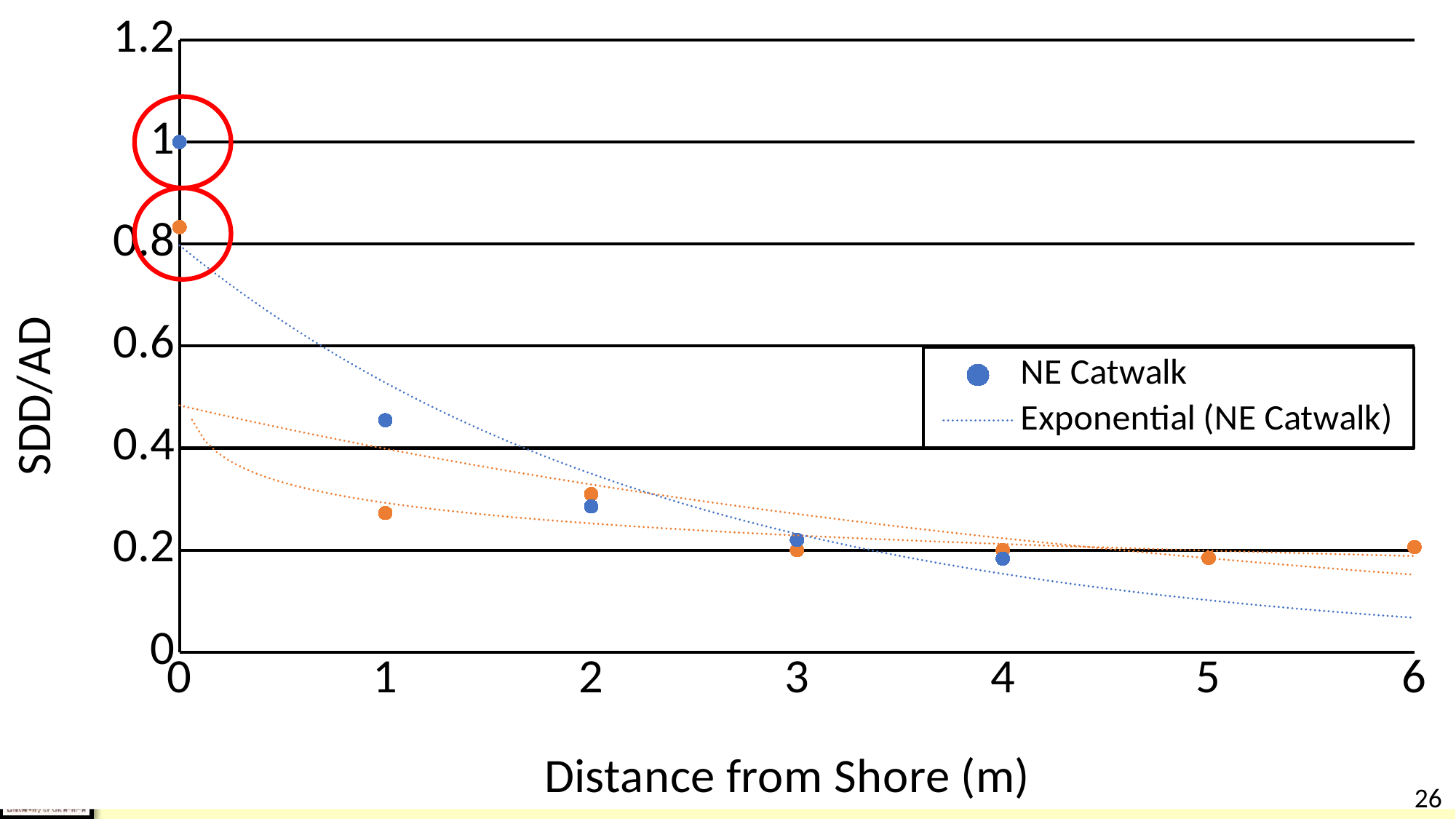
What is the label of the y axis? SDD/AD What is the SDD/AD value for NE Catwalk at a distance of 0 m from shore? 1 How many entries does the legend list? 2 What kind of chart is shown on the slide? Scatter chart Is the NE Catwalk value at 2 m from shore greater or less than 0.4? less Do the SDD/AD values rise or fall as distance from shore increases? Fall How many blue NE Catwalk data points are plotted? 5 Is the orange point at 0 m from shore greater or less than 0.8? greater What is the label of the x axis? Distance from Shore (m) Is the NE Catwalk value at 1 m from shore greater or less than 0.4? greater At 1 m from shore, which is larger: the blue NE Catwalk point or the orange point? The blue NE Catwalk point At which distance from shore is the NE Catwalk value highest? 0